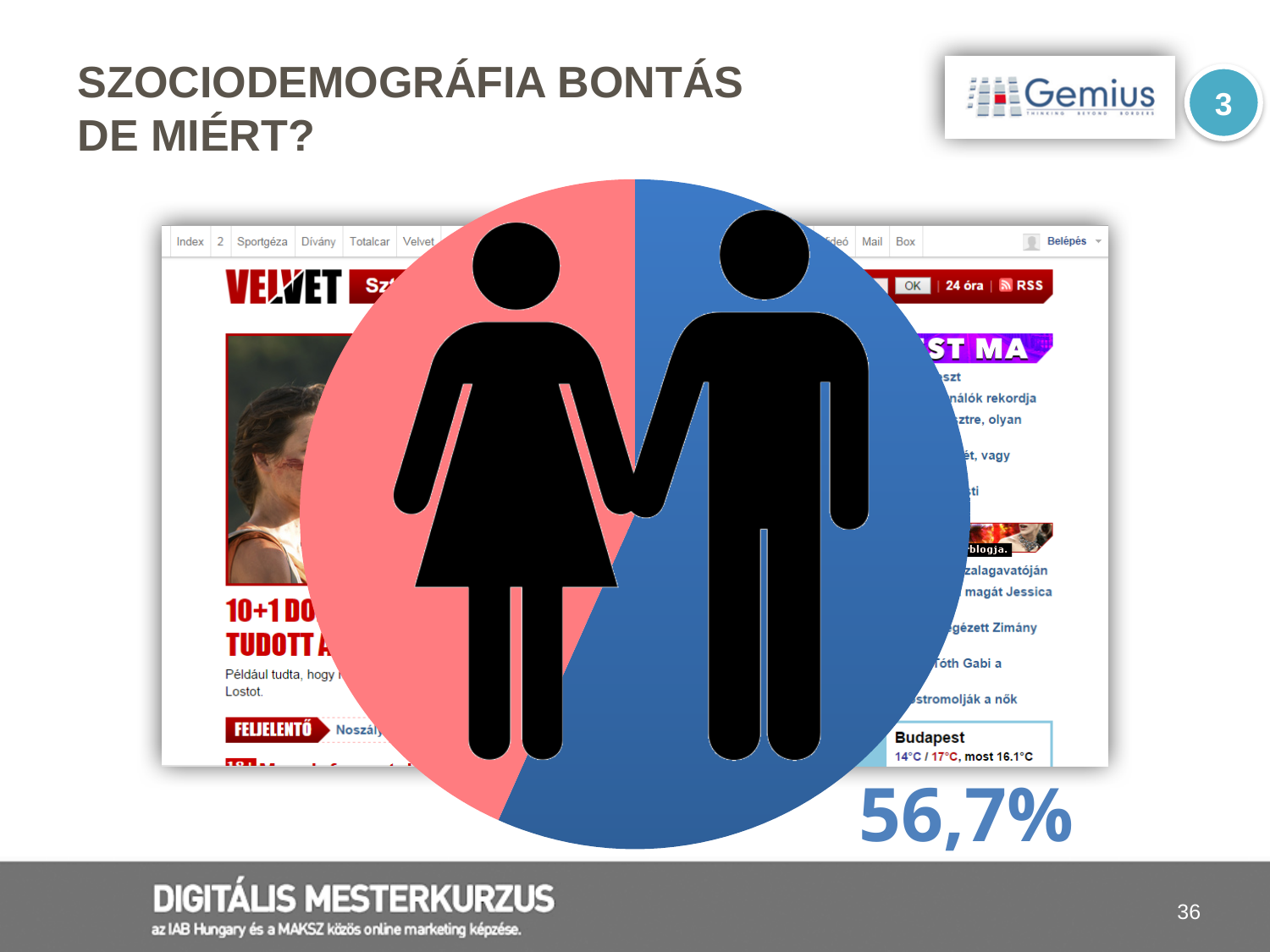
What colour is the slice containing the female figure? pink What is the title of the slide containing the pie chart? SZOCIODEMOGRÁFIA BONTÁS DE MIÉRT? What percentage is printed for the blue slice (the one with the male figure)? 56,7% How many slices does the pie chart have? 2 Which slice of the pie chart is the smallest? the pink slice with the female figure What share of the pie does the blue slice with the male figure represent? 56,7% Which slice of the pie chart is larger, the blue one with the male figure or the pink one with the female figure? the blue one with the male figure What kind of chart is shown on the slide? pie chart